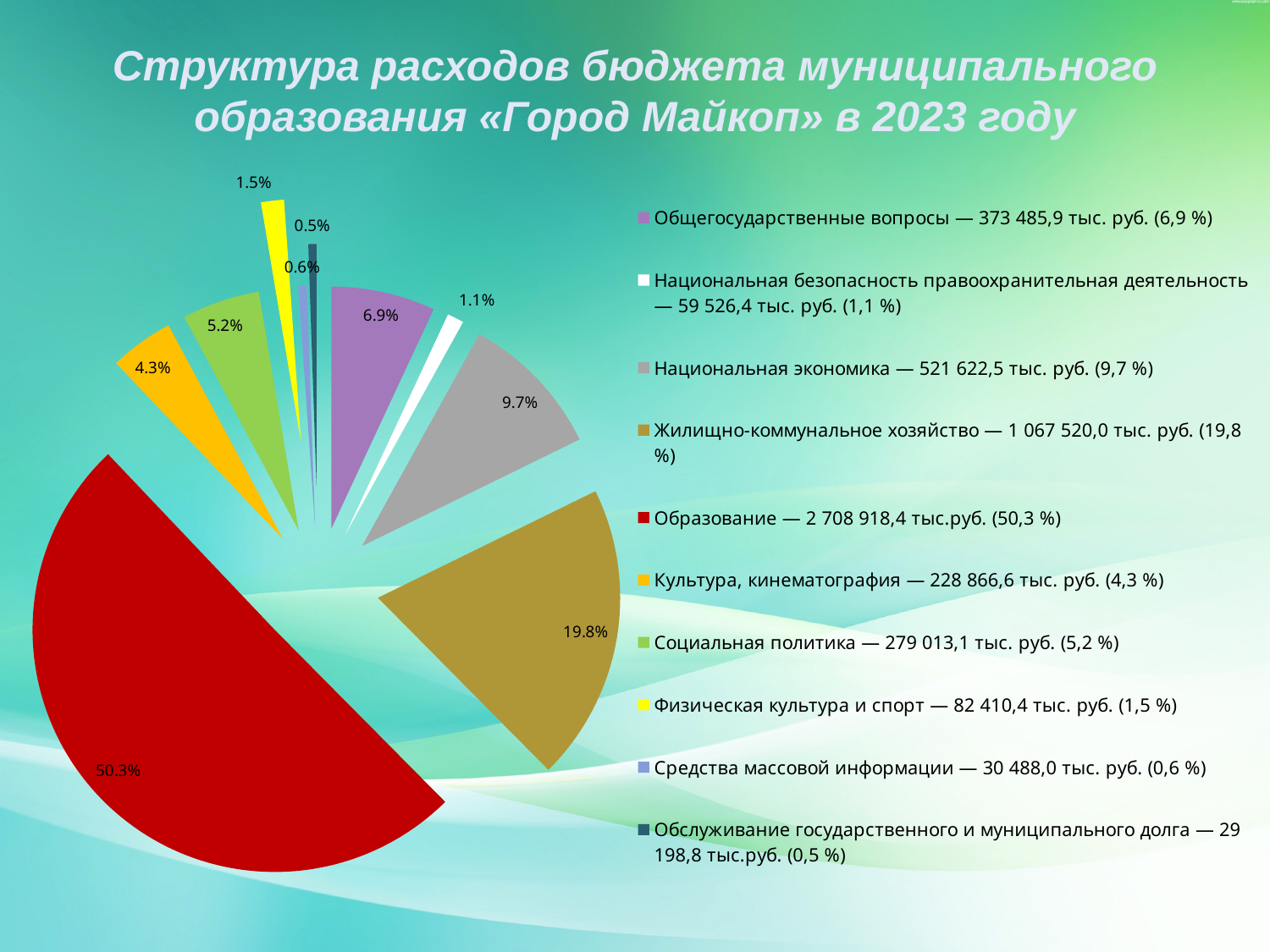
What share of the budget expenditure does Жилищно-коммунальное хозяйство account for? 19.8% What is the title of the slide? Структура расходов бюджета муниципального образования «Город Майкоп» в 2023 году What share of the pie chart does Физическая культура и спорт represent? 1.5% Which category has the smallest share of the pie chart? Обслуживание государственного и муниципального долга By how many percentage points does the share of Национальная экономика exceed that of Общегосударственные вопросы? 2.8 percentage points Which has the larger share: Социальная политика or Культура, кинематография? Социальная политика What kind of chart is shown on the slide? Pie chart What is the combined share of Образование and Жилищно-коммунальное хозяйство? 70.1% Which category has the largest share of the pie chart? Образование According to the legend, what is the amount of expenditure on Образование? 2 708 918,4 тыс.руб. How many slices does the pie chart have? 10 What share of the budget expenditure does Образование account for? 50.3%